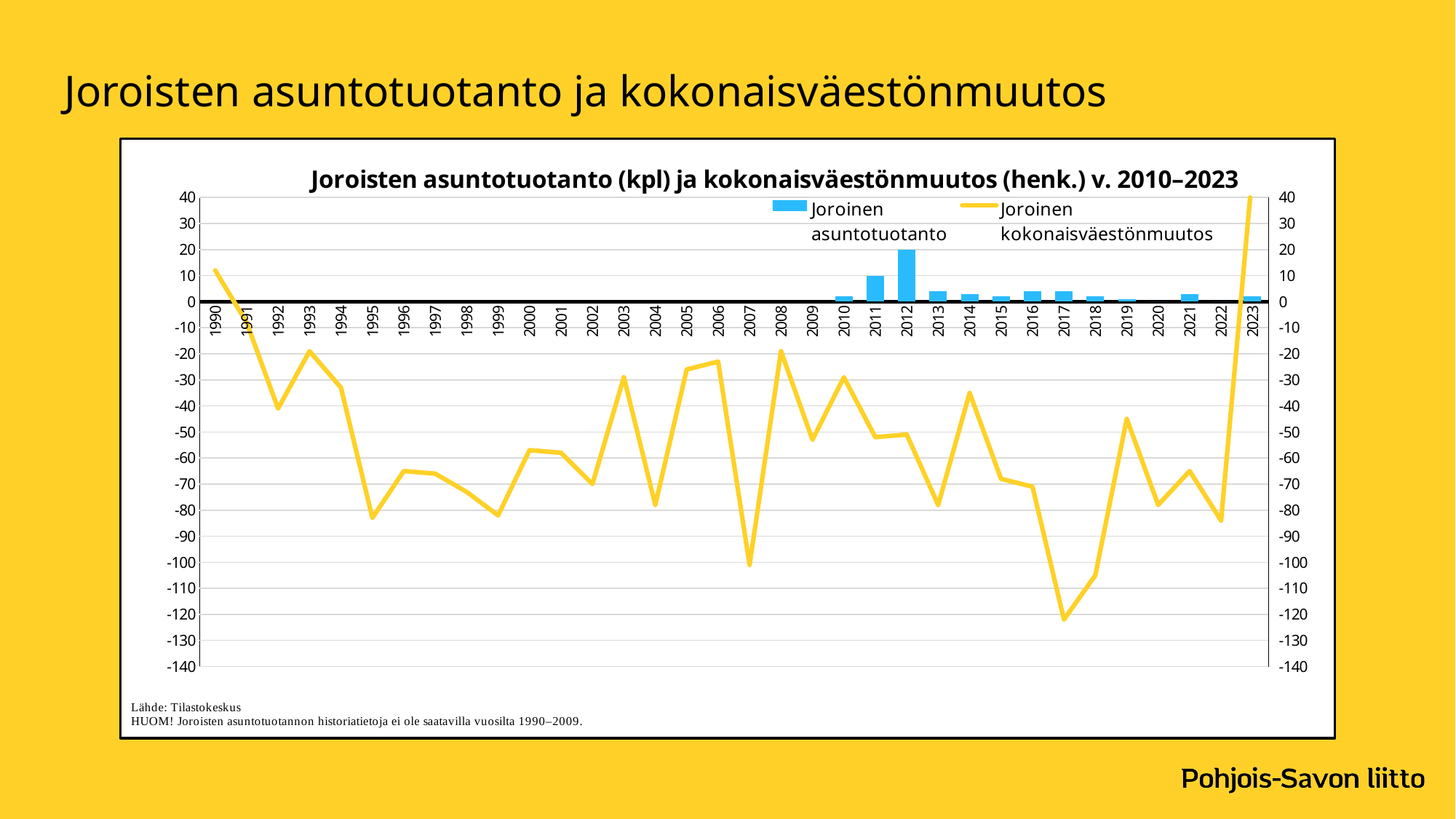
How many series does the legend list? 2 In which year is the Joroinen asuntotuotanto bar the highest? 2012 Is the Joroinen asuntotuotanto value for 2012 greater or less than 10? greater Which year has the larger Joroinen asuntotuotanto bar, 2011 or 2012? 2012 What kind of chart is shown on the slide? A combined bar and line chart How many years are shown on the x axis? 34 Which year has the higher Joroinen kokonaisväestönmuutos value, 2007 or 2008? 2008 What colour is the Joroinen kokonaisväestönmuutos line? Yellow Is the Joroinen kokonaisväestönmuutos value for 2023 greater or less than 30? greater In which year does the Joroinen kokonaisväestönmuutos line reach its lowest value? 2017 Is the Joroinen kokonaisväestönmuutos value for 2017 greater or less than -100? less In which year does the Joroinen kokonaisväestönmuutos line reach its highest value? 2023